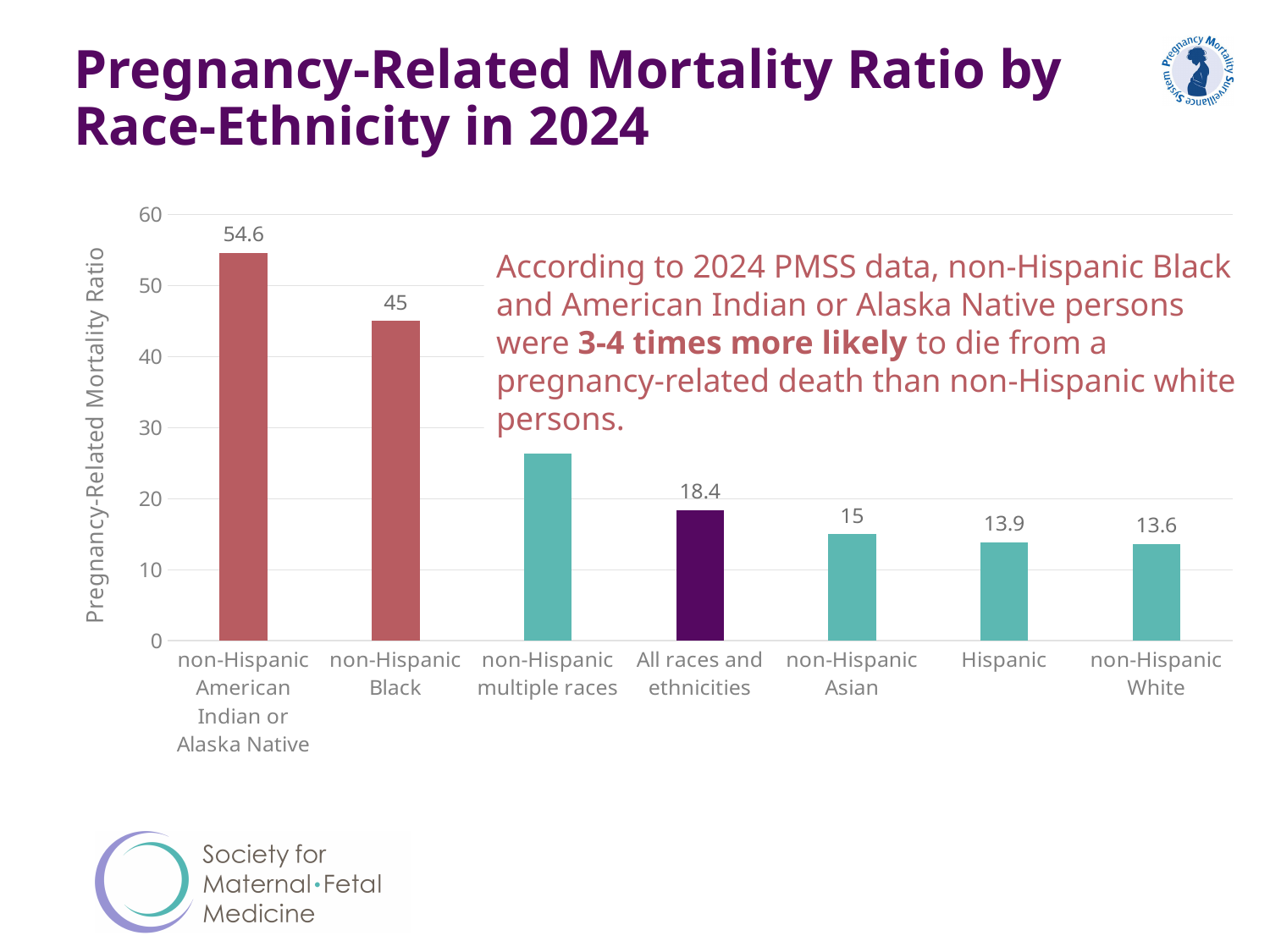
Is the value for non-Hispanic multiple races greater or less than 20? greater Which race-ethnicity group has the lowest pregnancy-related mortality ratio? non-Hispanic White What is the difference between the mortality ratio for non-Hispanic American Indian or Alaska Native persons and non-Hispanic Black persons? 9.6 What kind of chart is shown on the slide? bar chart Which race-ethnicity group has the highest pregnancy-related mortality ratio? non-Hispanic American Indian or Alaska Native Is the value for non-Hispanic multiple races greater or less than 30? less How many race-ethnicity categories are shown on the chart? 7 What is the pregnancy-related mortality ratio for Hispanic persons? 13.9 Which is larger, the mortality ratio for non-Hispanic Asian persons or for non-Hispanic White persons? non-Hispanic Asian What is the value shown for All races and ethnicities? 18.4 What is the pregnancy-related mortality ratio for non-Hispanic American Indian or Alaska Native persons? 54.6 What is the pregnancy-related mortality ratio for non-Hispanic Black persons? 45